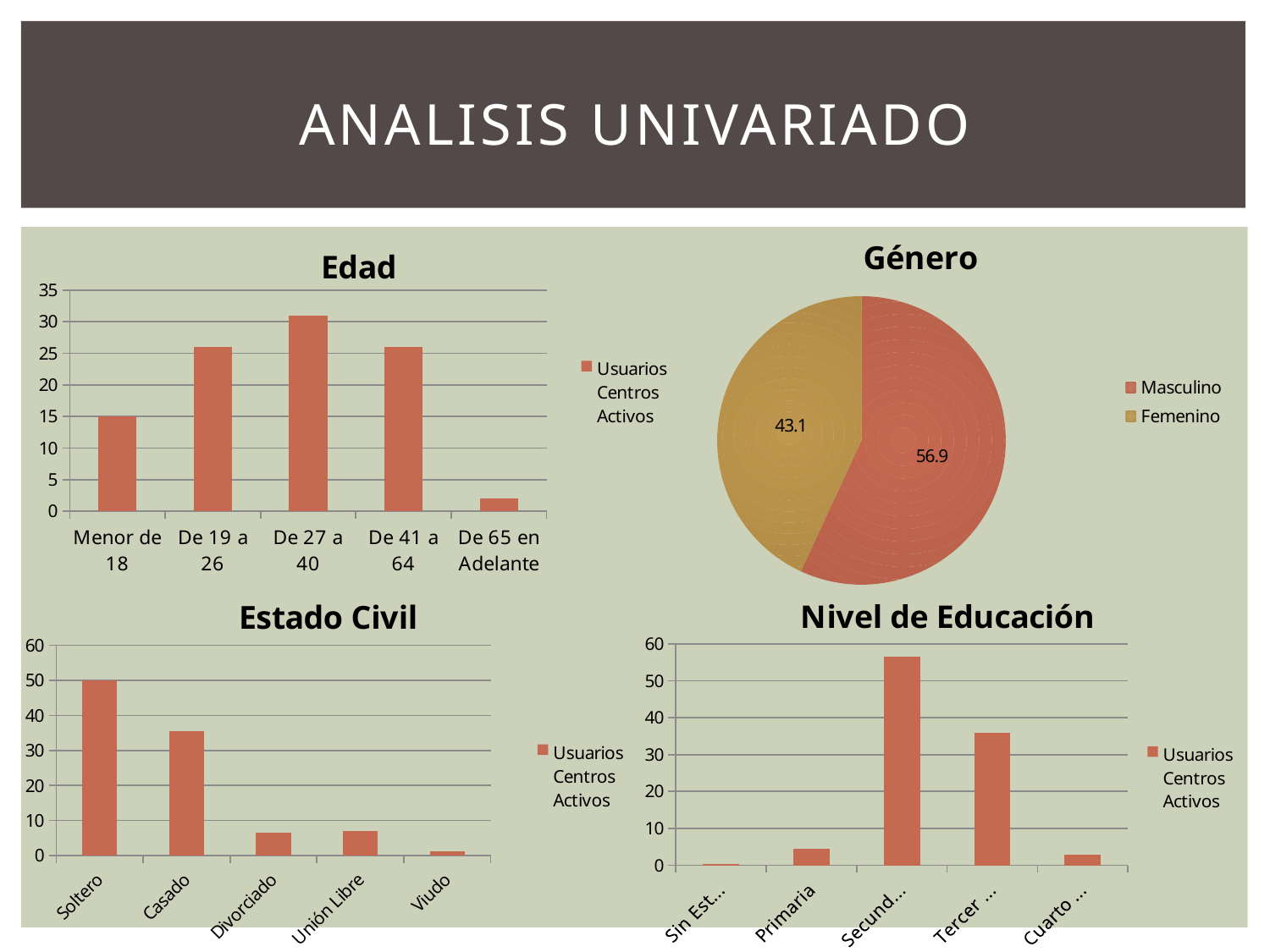
In the Género pie chart, what is the difference between the Masculino and Femenino values? 13.8 What type of chart is the Género chart? Pie chart In the Edad chart, which age category has the lowest value? De 65 en Adelante In the Edad chart, which age category has the highest value? De 27 a 40 In the Género pie chart, what is the value shown for Femenino? 43.1 In the Género pie chart, what is the value shown for Masculino? 56.9 In the Estado Civil chart, which category has the highest value? Soltero In the Edad chart, is the value for De 27 a 40 greater or less than 30? greater In the Estado Civil chart, which category has the lowest value? Viudo In the Género pie chart, which slice is larger, Masculino or Femenino? Masculino In the Estado Civil chart, is the value for Casado greater or less than 30? greater How many age categories are shown in the Edad chart? 5